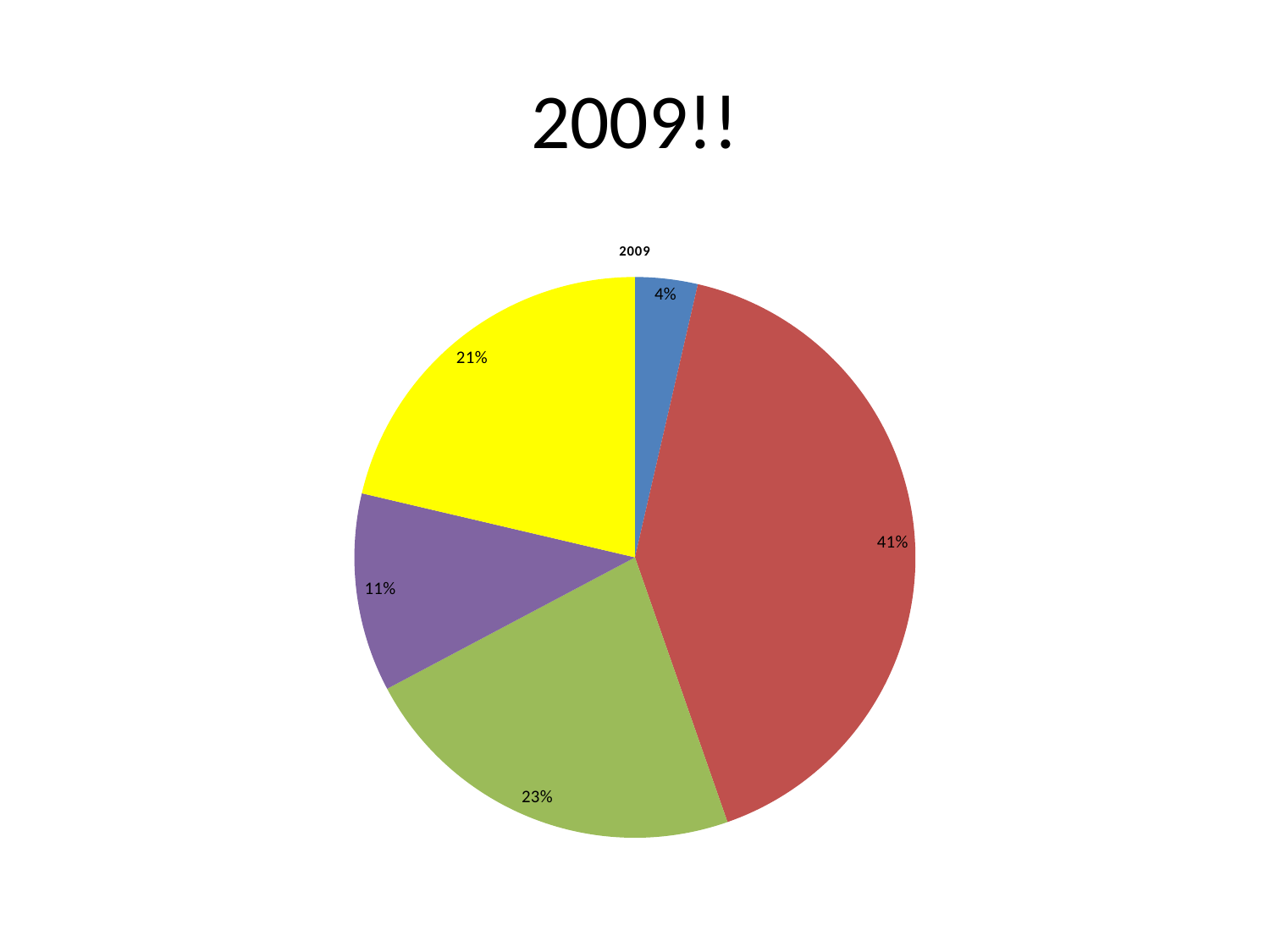
Which colour slice is the largest in the pie chart? red What is the title of the chart? 2009 What percentage is shown on the yellow slice of the pie chart? 21% What is the difference in percentage points between the red slice and the green slice? 18 Which colour slice is the smallest in the pie chart? blue What kind of chart is shown on the slide? pie chart What percentage is shown on the green slice of the pie chart? 23% What percentage is shown on the blue slice of the pie chart? 4% What percentage is shown on the red slice of the pie chart? 41% Which is larger, the yellow slice or the purple slice? yellow How many slices does the pie chart have? 5 What percentage is shown on the purple slice of the pie chart? 11%